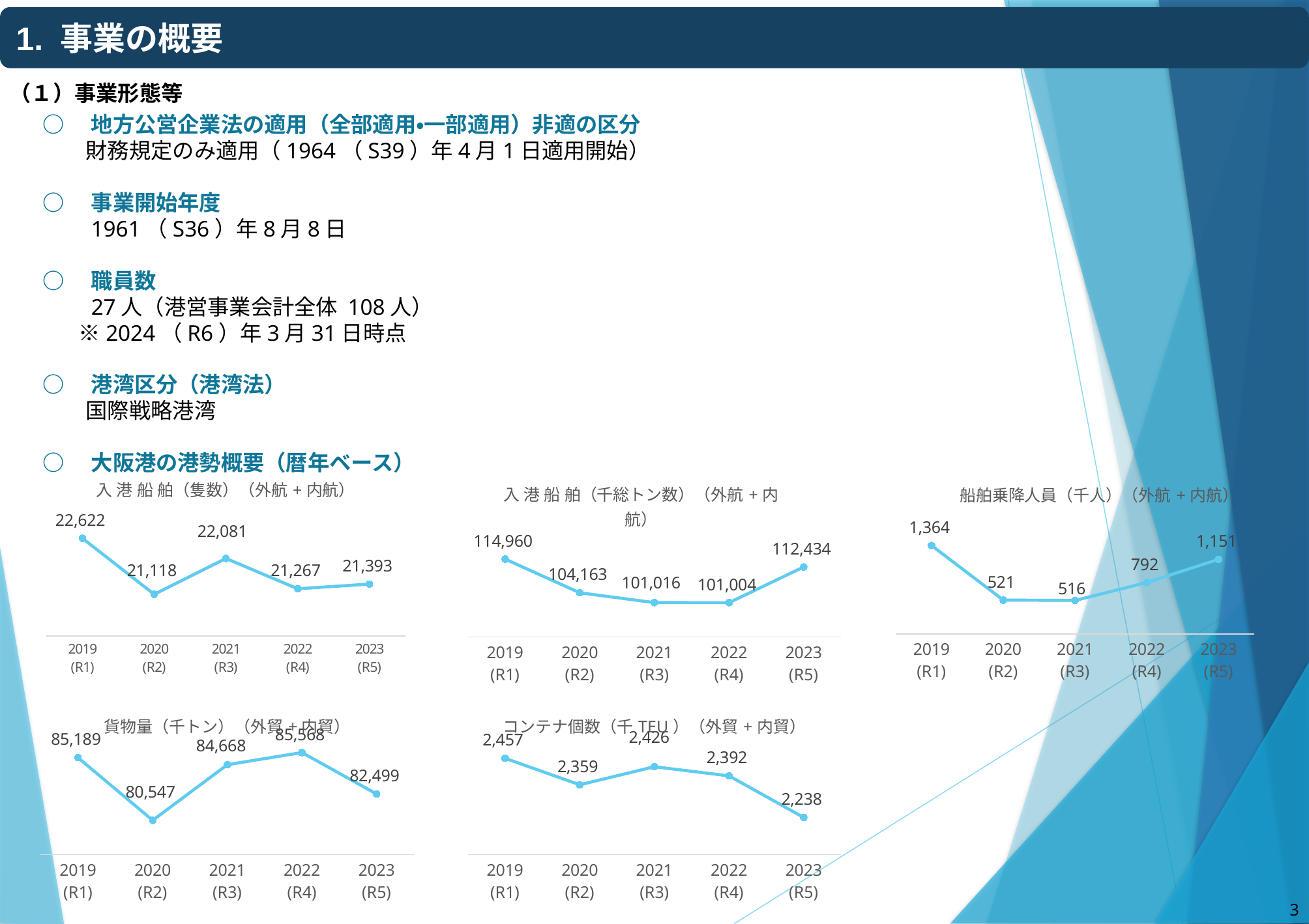
How many data points does the コンテナ個数（千TEU） chart show? 5 What type of chart is the 貨物量（千トン） chart? Line chart In the 入港船舶（千総トン数） chart, which year has the highest value? 2019 (R1) In the コンテナ個数（千TEU） chart, which is larger, the value for 2021 (R3) or the value for 2022 (R4)? 2021 (R3) In the 入港船舶（千総トン数） chart, what is the value for 2023 (R5)? 112,434 In the 貨物量（千トン） chart, what is the value for 2020 (R2)? 80,547 In the 入港船舶（隻数） chart, what is the value for 2019 (R1)? 22,622 In the 船舶乗降人員（千人） chart, what is the difference between the 2019 (R1) value and the 2020 (R2) value? 843 In the 船舶乗降人員（千人） chart, what is the value for 2022 (R4)? 792 In the コンテナ個数（千TEU） chart, what is the value for 2023 (R5)? 2,238 In the 貨物量（千トン） chart, which year has the highest value? 2022 (R4) In the 入港船舶（隻数） chart, which year has the lowest value? 2020 (R2)